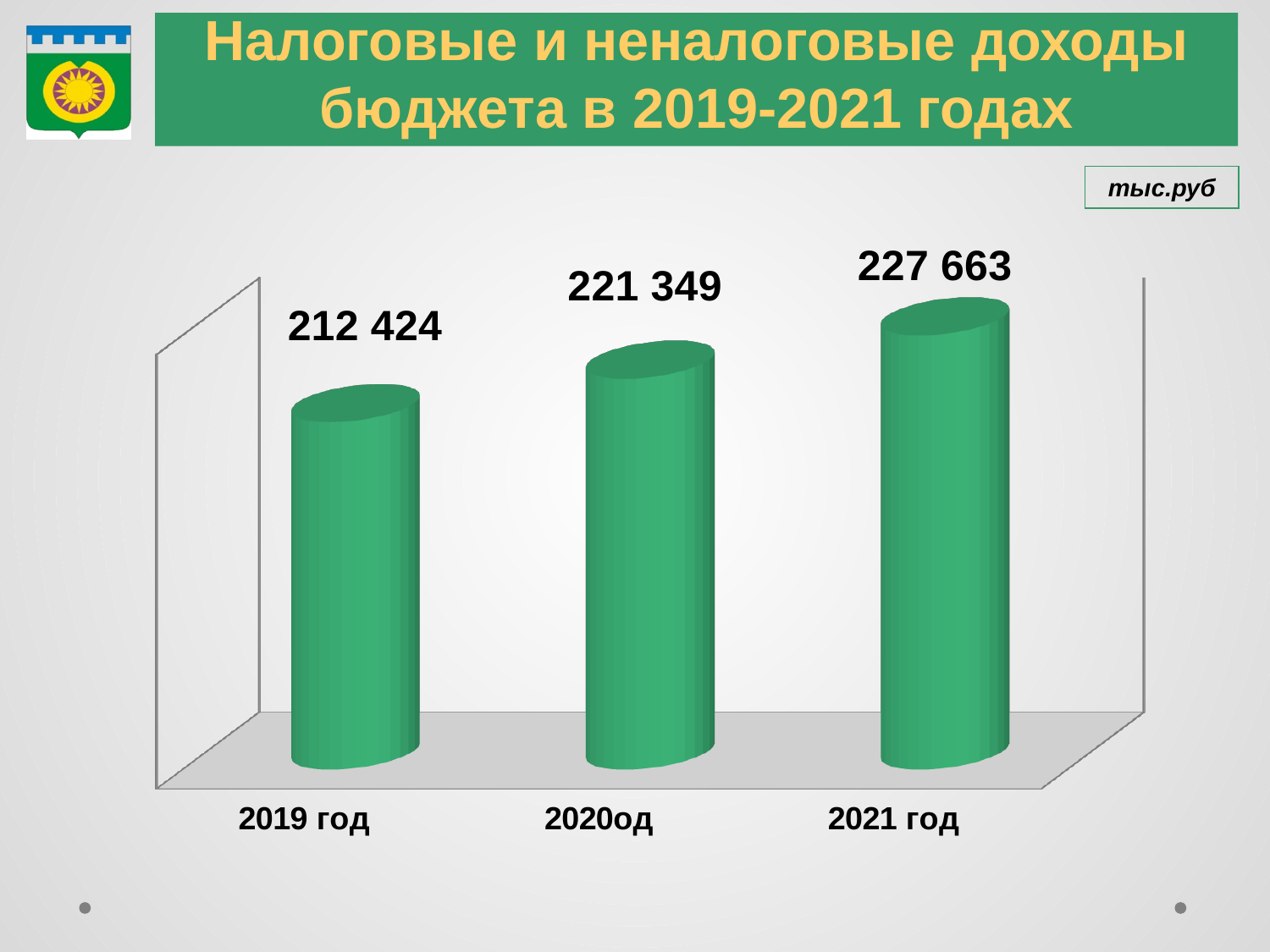
What is the difference between the values for 2021 год and 2019 год? 15 239 What kind of chart is shown on the slide? Bar chart Which is larger, the value for 2019 год or the value for 2021 год? 2021 год What is the difference between the values for 2020 and 2019 год? 8 925 What is the value shown for 2021 год? 227 663 What is the value shown for the 2020 bar? 221 349 Which year has the highest value? 2021 год Which year has the lowest value? 2019 год How many bars are shown in the chart? 3 Do the values rise or fall from 2019 to 2021? Rise What is the value shown for 2019 год? 212 424 What is the difference between the values for 2021 год and 2020? 6 314